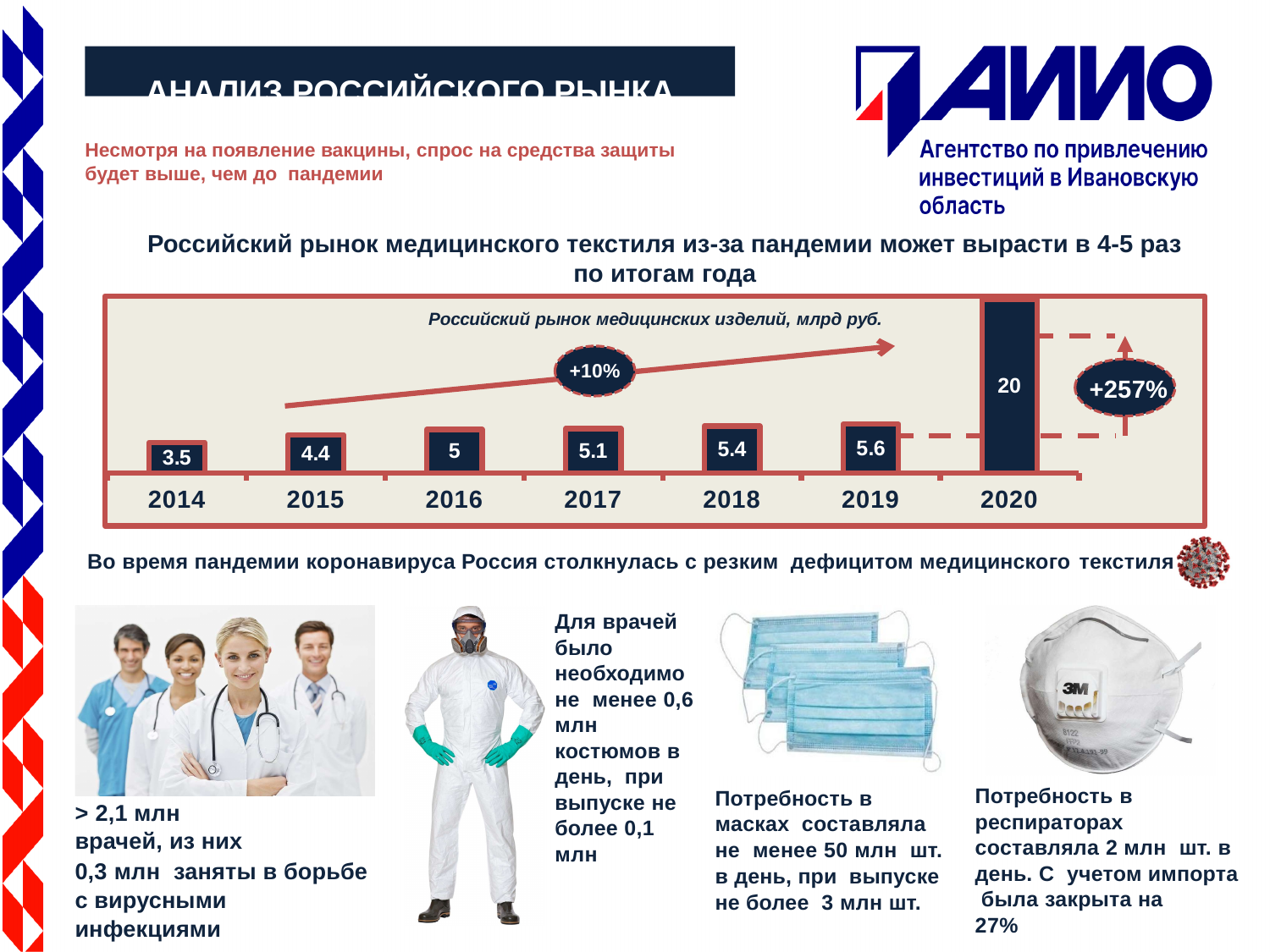
Which year has the lowest value in the chart "Российский рынок медицинских изделий, млрд руб."? 2014 How many years are shown in the chart "Российский рынок медицинских изделий, млрд руб."? 7 What percentage growth is annotated next to the 2020 bar in the chart "Российский рынок медицинских изделий, млрд руб."? +257% What kind of chart is "Российский рынок медицинских изделий, млрд руб."? bar chart What is the difference between the 2020 and 2019 values in the chart "Российский рынок медицинских изделий, млрд руб."? 14.4 Do the values in the chart "Российский рынок медицинских изделий, млрд руб." rise or fall from 2014 to 2020? rise What is the value for 2019 in the chart "Российский рынок медицинских изделий, млрд руб."? 5.6 In the chart "Российский рынок медицинских изделий, млрд руб.", which is larger, the value for 2016 or the value for 2018? 2018 What is the value for 2014 in the chart "Российский рынок медицинских изделий, млрд руб."? 3.5 Which year has the highest value in the chart "Российский рынок медицинских изделий, млрд руб."? 2020 What is the difference between the 2015 and 2014 values in the chart "Российский рынок медицинских изделий, млрд руб."? 0.9 What is the value for 2020 in the chart "Российский рынок медицинских изделий, млрд руб."? 20